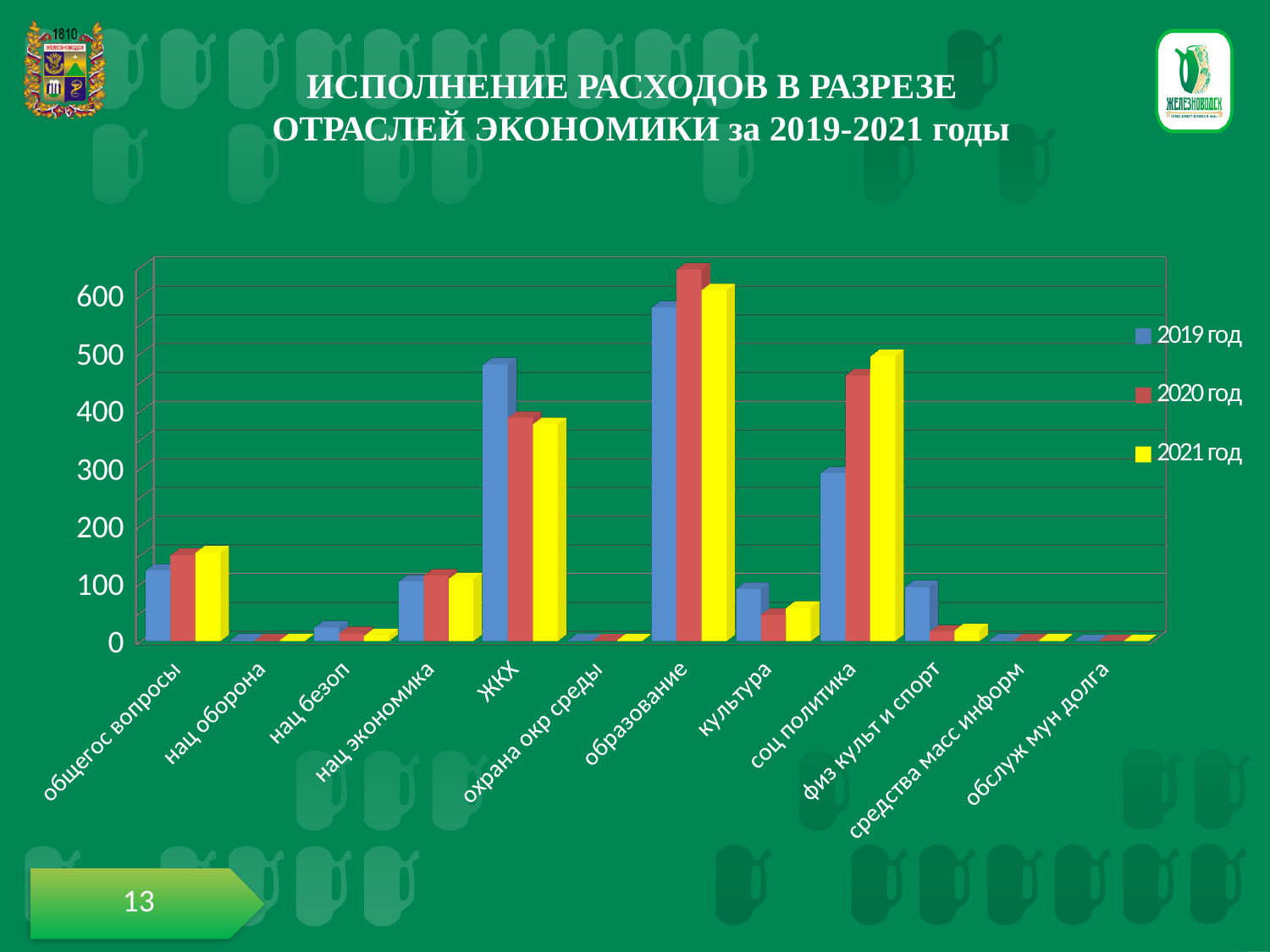
Which colour represents 2021 год in the legend? yellow Is the value for общегос вопросы in 2021 год greater or less than 100? greater For соц политика, which is larger: the value for 2019 год or 2021 год? 2021 год Is the value for ЖКХ in 2019 год greater or less than 400? greater How many series does the legend list? 3 For ЖКХ, which is larger: the value for 2019 год or 2020 год? 2019 год Which category has the highest value for 2019 год? образование Is the value for образование in 2020 год greater or less than 600? greater Which category has the highest value for 2021 год? образование How many categories are shown on the x axis? 12 What kind of chart is shown on the slide? bar chart